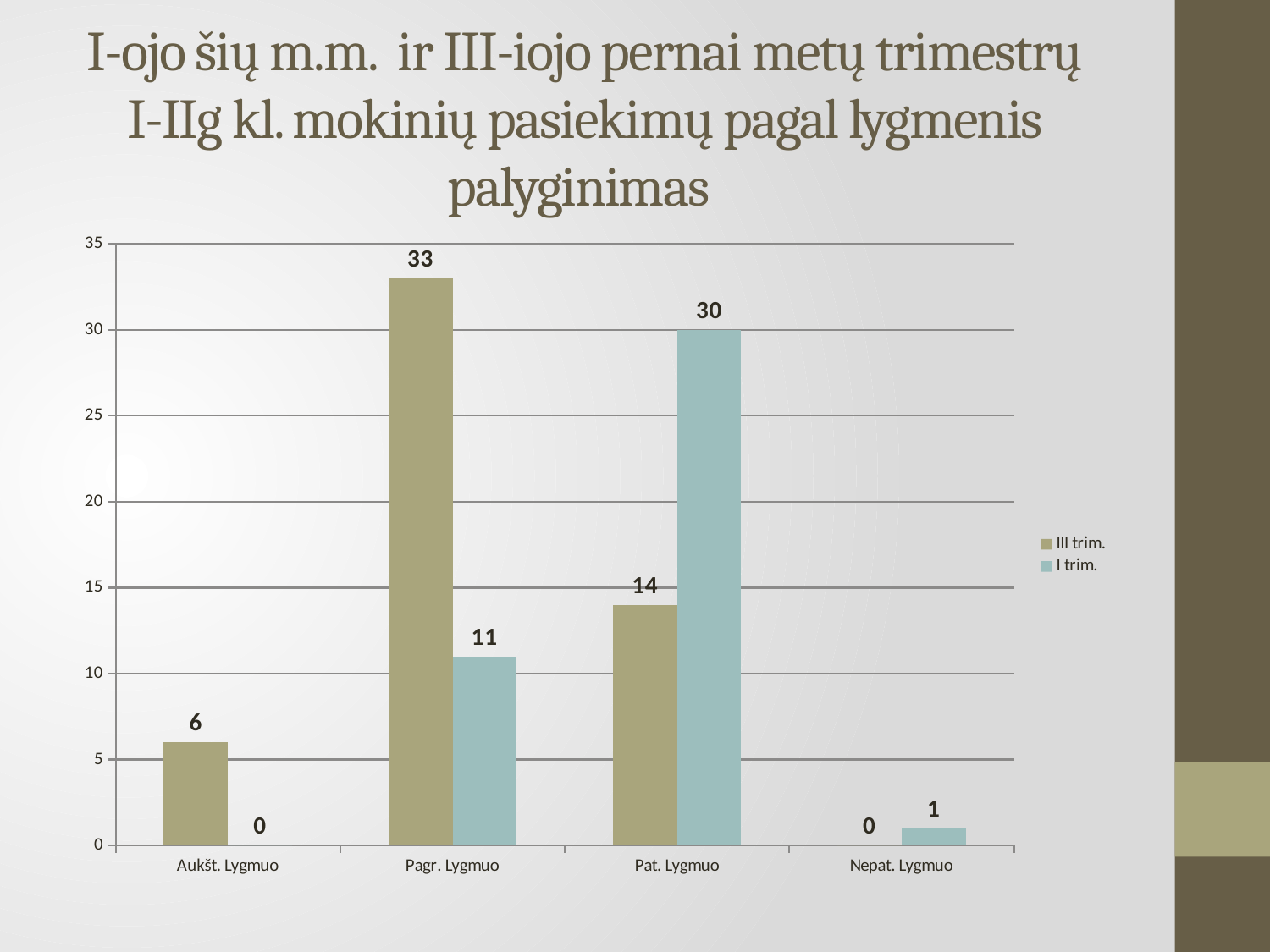
What is the value for III trim. in the Nepat. Lygmuo category? 0 How many series does the legend list? 2 Which category has the lowest value for the I trim. series? Aukšt. Lygmuo What is the value for I trim. in the Aukšt. Lygmuo category? 0 How many categories are shown on the x axis? 4 In the Pat. Lygmuo category, which series has the larger value, III trim. or I trim.? I trim. What is the total of the III trim. and I trim. values in the Nepat. Lygmuo category? 1 What is the difference between the III trim. and I trim. values in the Pagr. Lygmuo category? 22 What kind of chart is shown on the slide? Bar chart Which category has the highest value for the III trim. series? Pagr. Lygmuo What is the value for III trim. in the Pagr. Lygmuo category? 33 What is the value for I trim. in the Pat. Lygmuo category? 30